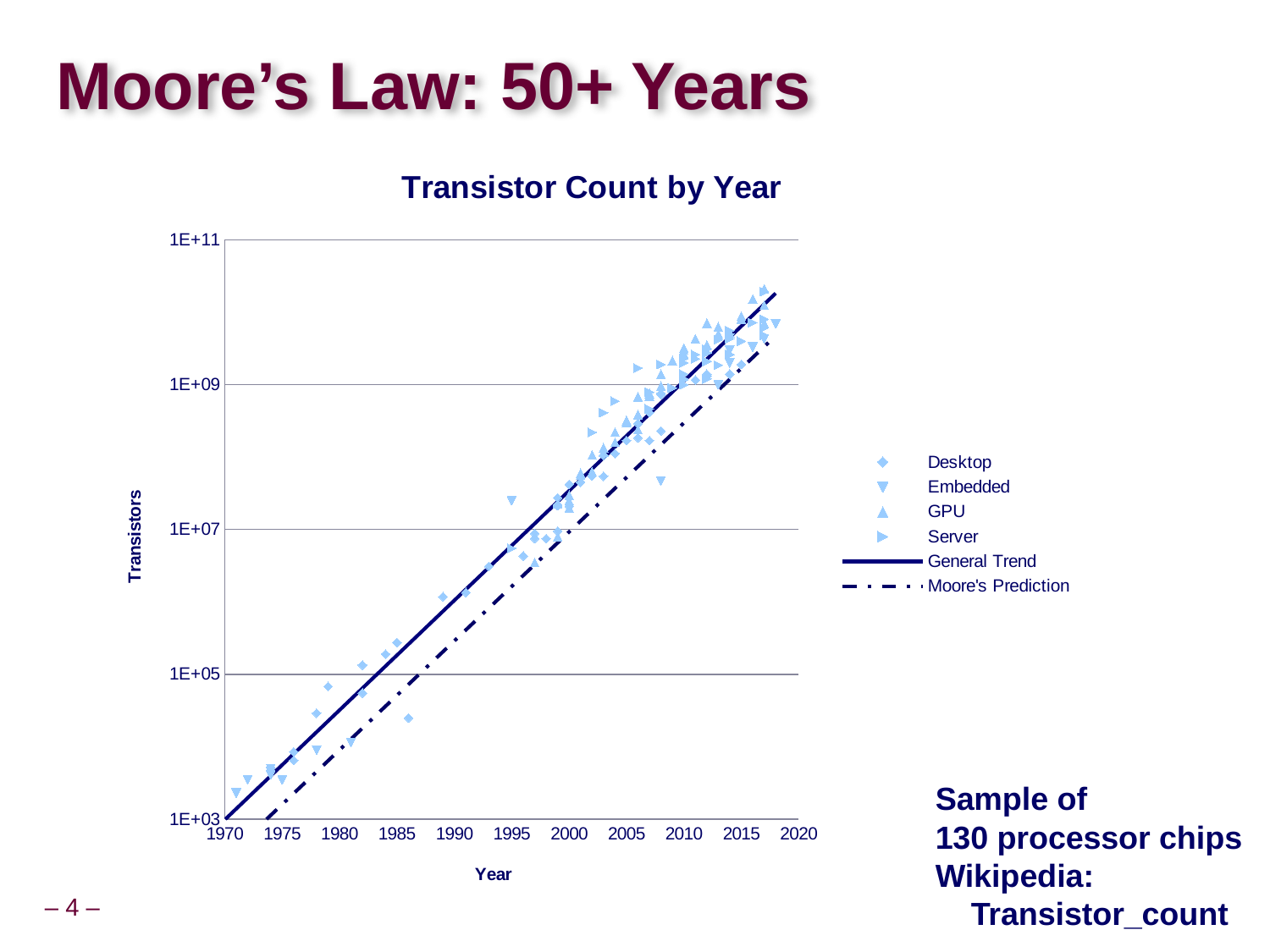
What kind of chart is shown on the slide? scatter chart At 2010, which line is higher: General Trend or Moore's Prediction? General Trend Do the transistor counts rise or fall as the year increases along the x axis? rise Is the General Trend line at 1980 greater or less than 1E+05 transistors? less What is the lowest value labelled on the y axis of the chart? 1E+03 How many entries does the legend of the Transistor Count by Year chart list? 6 How many year tick labels are shown on the x axis of the chart? 11 Is the General Trend line at 1990 greater or less than 1E+05 transistors? greater What label is shown on the y axis of the chart? Transistors Is the General Trend line at 1990 greater or less than 1E+07 transistors? less What is the highest value labelled on the y axis of the chart? 1E+11 What is the title of the chart? Transistor Count by Year